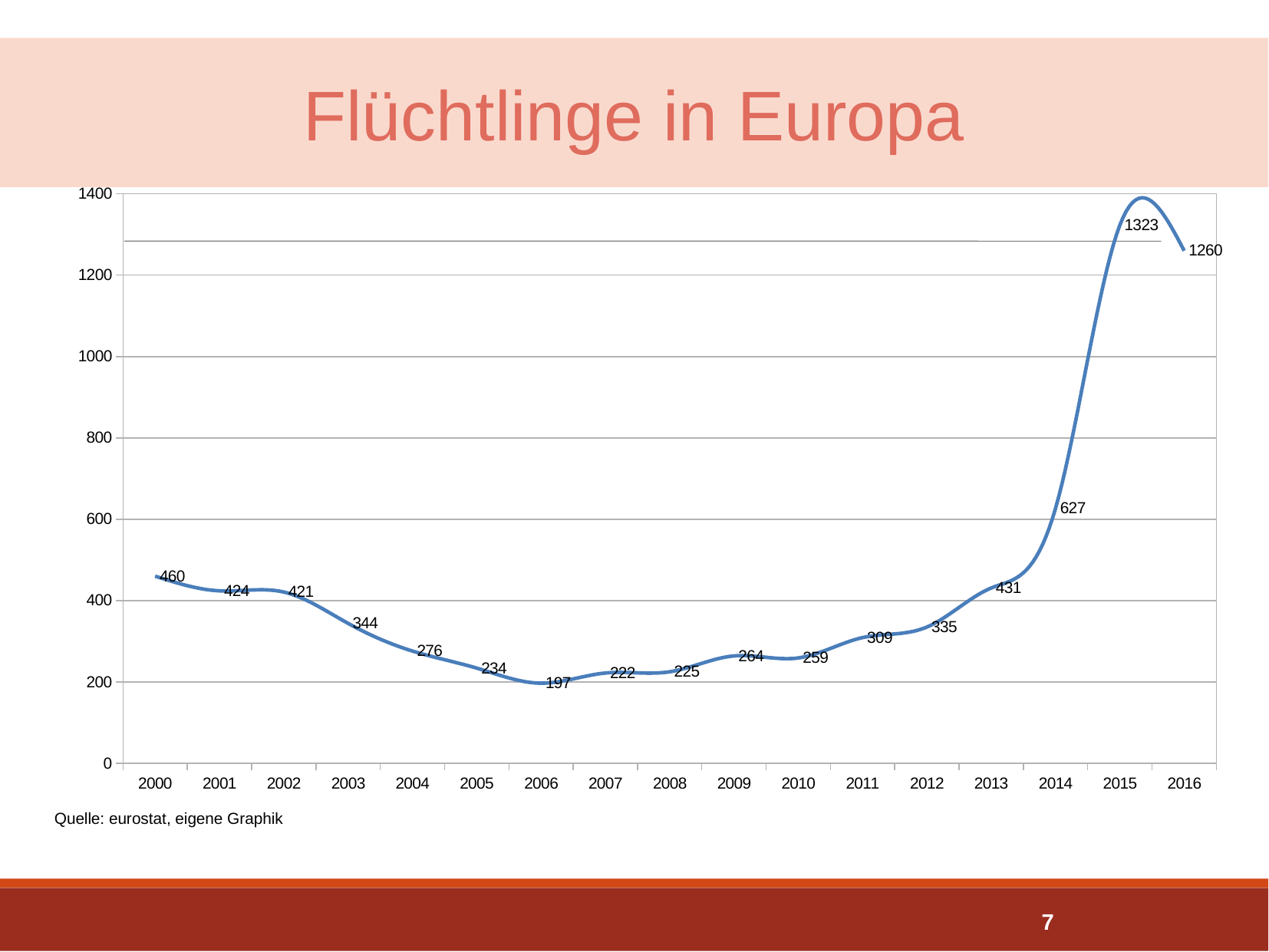
Is the value for 2014 greater or less than 600? greater Which is larger, the value for 2013 or the value for 2001? 2013 What is the title of the chart? Flüchtlinge in Europa What is the value for 2000? 460 What kind of chart is shown? line chart How many years are plotted on the x axis? 17 Which year has the lowest value? 2006 Do the values rise or fall from 2000 to 2006? fall What is the value for 2006? 197 What is the value for 2015? 1323 What is the difference between the values for 2015 and 2014? 696 Which year has the highest value? 2015